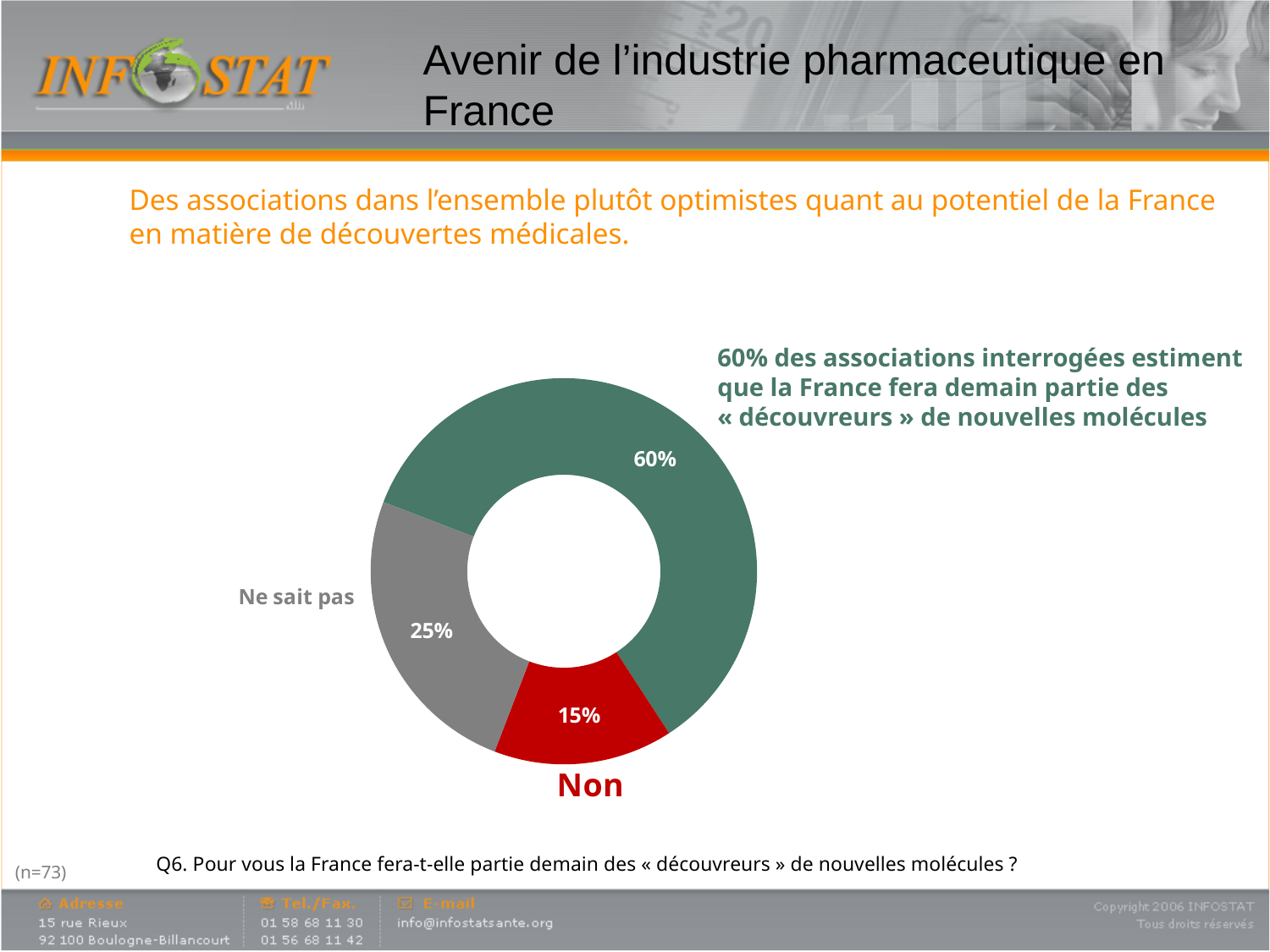
What is the difference between the "Ne sait pas" slice and the "Non" slice? 10 percentage points What is the difference between the green slice and the "Non" slice? 45 percentage points What percentage is shown for the "Ne sait pas" slice? 25% What kind of chart is shown on the slide? Donut (pie) chart Which labelled slice of the chart is the smallest? Non What colour is the "Non" slice? Red What percentage is shown for the green slice of the chart? 60% Which slice of the chart is the largest? The green slice (60%) What percentage is shown for the "Non" slice? 15% What is the sample size (n) indicated on the slide? n=73 Which is larger, the "Ne sait pas" slice or the "Non" slice? Ne sait pas How many slices does the chart have? 3